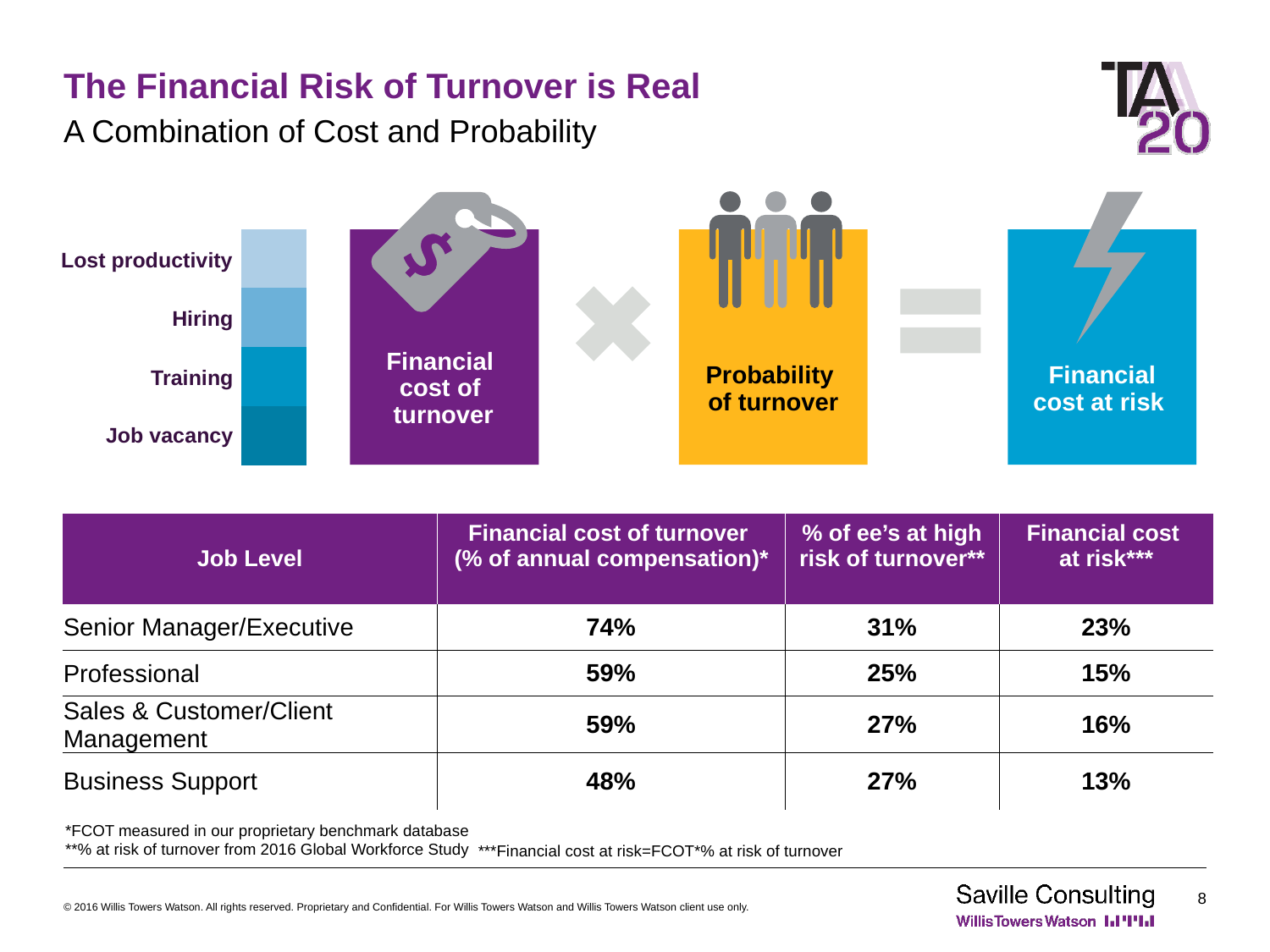
How many segments make up the stacked bar on the left of the slide? 4 Which segment is at the bottom of the stacked bar on the left of the slide? Job vacancy In the table, which job level has the highest financial cost at risk? Senior Manager/Executive Which segment is at the top of the stacked bar on the left of the slide? Lost productivity What kind of chart is the graphic on the left of the slide showing Lost productivity, Hiring, Training and Job vacancy? Stacked bar chart In the table, what is the financial cost at risk for Business Support? 13% In the table, is the % of ee's at high risk of turnover larger for Senior Manager/Executive or for Professional? Senior Manager/Executive In the table, what is the difference in financial cost at risk between Senior Manager/Executive and Professional? 8% In the table, what is the % of ee's at high risk of turnover for Professional? 25% In the table, what is the financial cost of turnover (% of annual compensation) for Senior Manager/Executive? 74% How many job levels are listed in the table? 4 In the table, which job level has the lowest financial cost of turnover (% of annual compensation)? Business Support